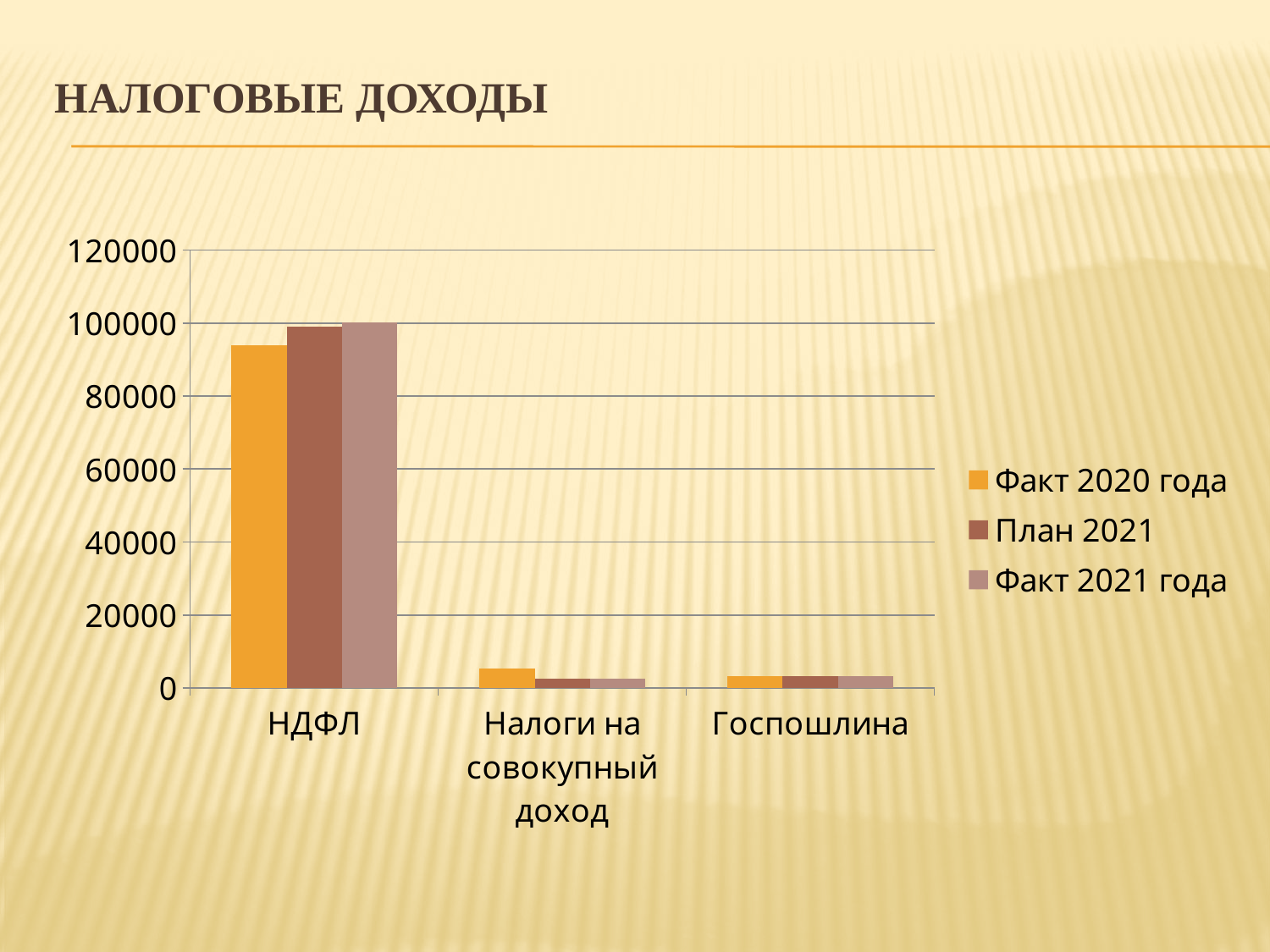
What kind of chart is shown on the slide? bar chart For НДФЛ, which is larger: the Факт 2020 года value or the Факт 2021 года value? Факт 2021 года Is the value for НДФЛ in the Факт 2020 года series greater or less than 80000? greater Is the value for Налоги на совокупный доход in the Факт 2021 года series greater or less than 20000? less What is the title of the slide? НАЛОГОВЫЕ ДОХОДЫ Is the value for Госпошлина in the План 2021 series greater or less than 20000? less How many categories are shown on the x axis of the chart? 3 For Налоги на совокупный доход, which is larger: the Факт 2020 года value or the План 2021 value? Факт 2020 года Which category has the highest values across all series? НДФЛ How many series does the legend list? 3 Which series is shown in the orange colour in the legend? Факт 2020 года